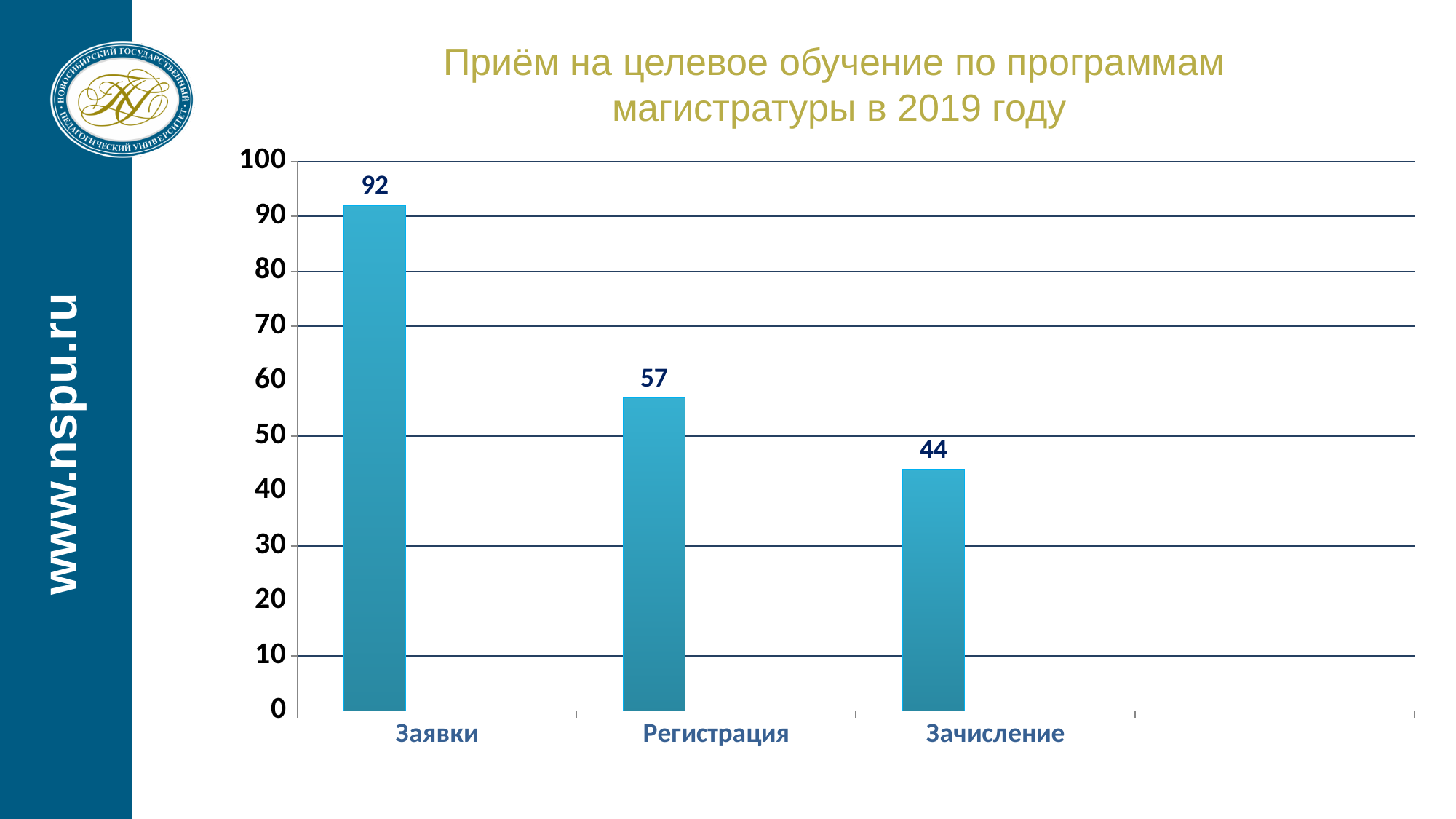
Which is larger, the value for Регистрация or the value for Зачисление? Регистрация What is the difference between the values for Заявки and Регистрация? 35 What is the value for Заявки? 92 What is the difference between the values for Регистрация and Зачисление? 13 What is the value for Зачисление? 44 What is the value for Регистрация? 57 Which category has the lowest value? Зачисление Which category has the highest value? Заявки What kind of chart is shown on the slide? bar chart How many categories are shown on the x axis? 3 Is the value for Зачисление greater or less than 50? less Do the values rise or fall from left to right along the x axis? fall